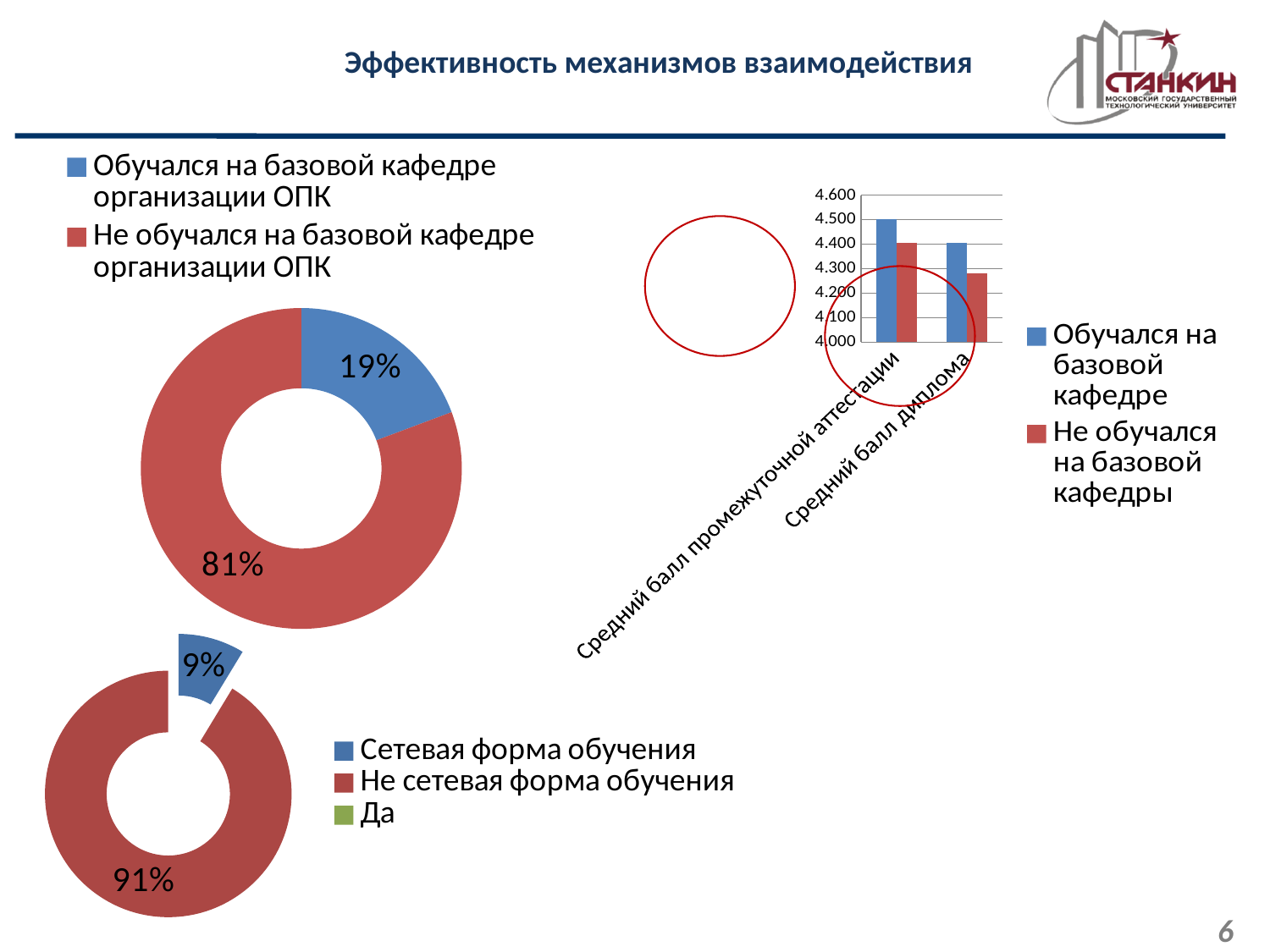
In the bar chart on the right, for 'Средний балл промежуточной аттестации', which series has the higher value? Обучался на базовой кафедре In the top-left doughnut chart, which category has the larger share? Не обучался на базовой кафедре организации ОПК In the bar chart on the right, how many categories are shown on the x axis? 2 In the bottom-left doughnut chart, what share is shown for 'Не сетевая форма обучения'? 91% How many entries does the legend of the bottom-left doughnut chart list? 3 What kind of chart is the chart on the right side of the slide? bar chart In the top-left doughnut chart, what share is shown for 'Не обучался на базовой кафедре организации ОПК'? 81% In the bar chart on the right, is the value for 'Обучался на базовой кафедре' in 'Средний балл диплома' greater or less than 4.300? greater In the bar chart on the right, is the value for 'Не обучался на базовой кафедры' in 'Средний балл диплома' greater or less than 4.400? less In the bottom-left doughnut chart, what is the difference between the shares of 'Не сетевая форма обучения' and 'Сетевая форма обучения'? 82% In the top-left doughnut chart, what share is shown for 'Обучался на базовой кафедре организации ОПК'? 19%